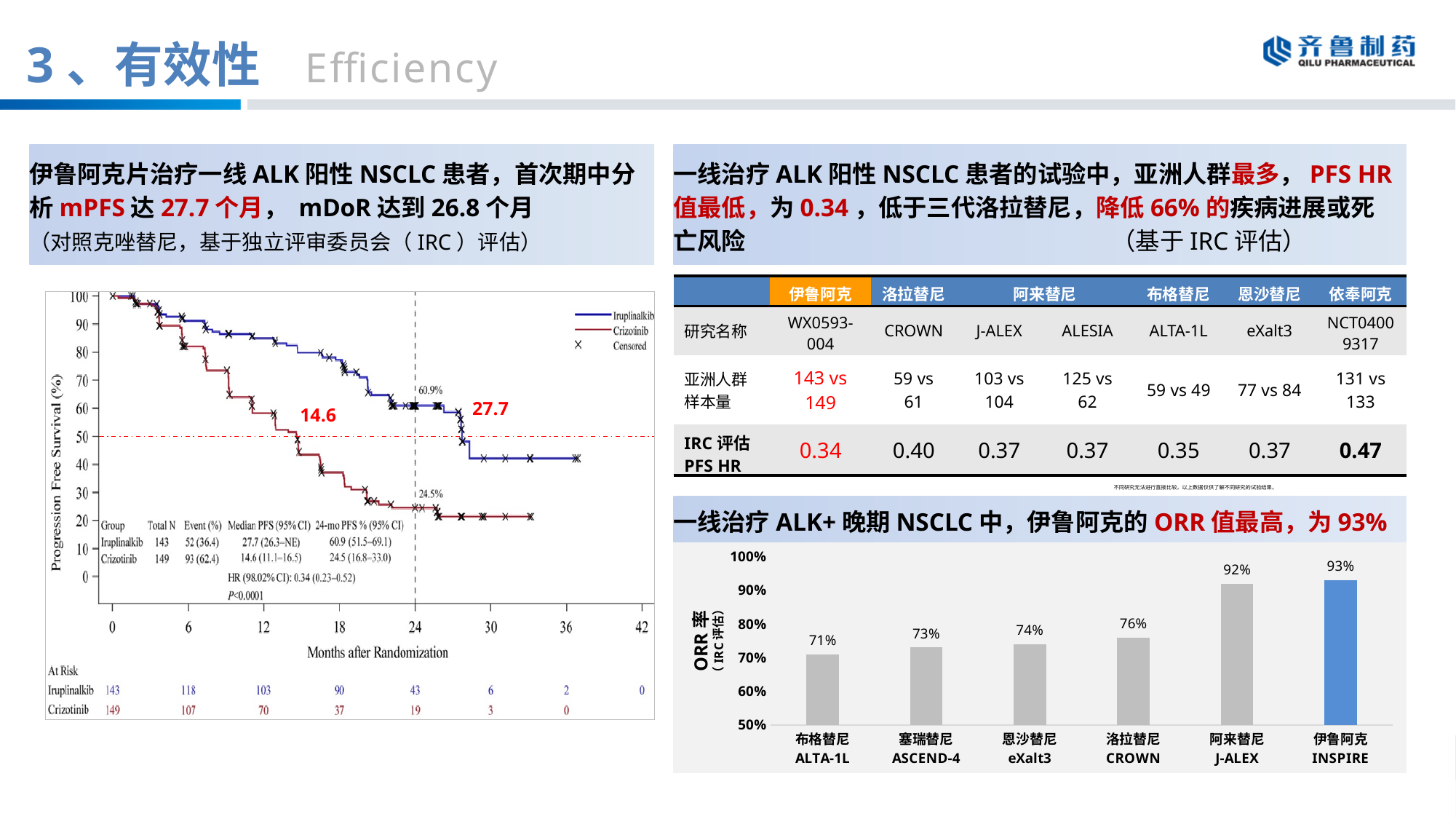
In the ORR bar chart at the bottom right, which drug has the lowest ORR? 布格替尼 (ALTA-1L) In the ORR bar chart at the bottom right, which drug has the highest ORR? 伊鲁阿克 (INSPIRE) In the ORR bar chart at the bottom right, which has a higher ORR, 洛拉替尼 (CROWN) or 恩沙替尼 (eXalt3)? 洛拉替尼 (CROWN) What kind of chart is the ORR chart at the bottom right of the slide? Bar chart In the progression-free survival curve on the left, what is the 24-month PFS rate for the Crizotinib group? 24.5% In the ORR bar chart at the bottom right, what is the difference between the ORR of 伊鲁阿克 (INSPIRE) and 阿来替尼 (J-ALEX)? 1% In the ORR bar chart at the bottom right, do the ORR values rise or fall from left to right? Rise In the ORR bar chart at the bottom right, what is the ORR value for 伊鲁阿克 (INSPIRE)? 93% In the ORR bar chart at the bottom right, which bar is coloured blue rather than grey? 伊鲁阿克 (INSPIRE) In the progression-free survival curve on the left, what is the median PFS (in months) for the Iruplinalkib group? 27.7 In the ORR bar chart at the bottom right, what is the ORR value for 布格替尼 (ALTA-1L)? 71% In the ORR bar chart at the bottom right, how many drugs/studies are shown as bars? 6